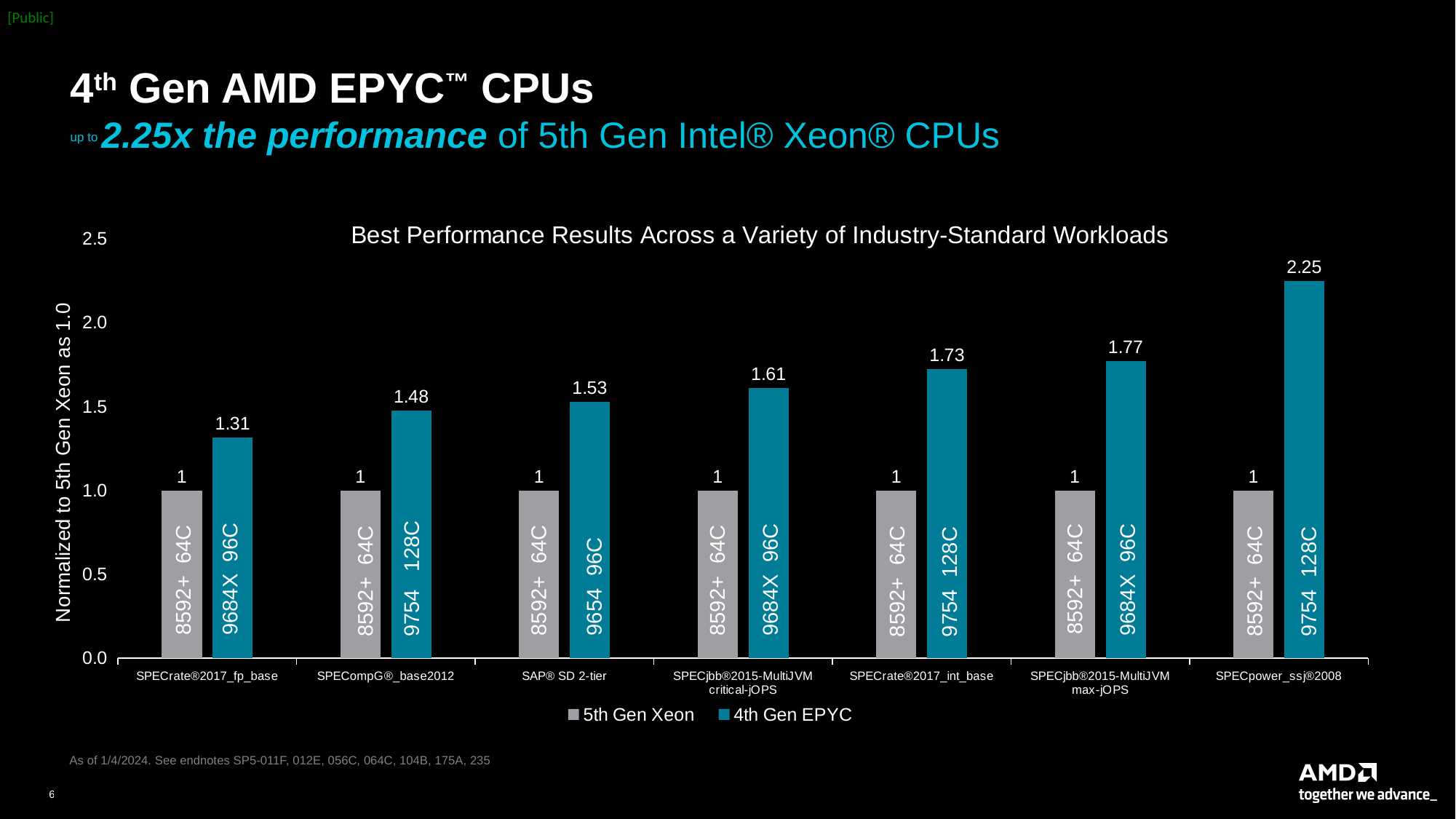
What is the title of the chart? Best Performance Results Across a Variety of Industry-Standard Workloads What kind of chart is shown on the slide? bar chart How many series does the legend list? 2 What is the 4th Gen EPYC value for SAP® SD 2-tier? 1.53 Which workload has the highest 4th Gen EPYC value? SPECpower_ssj®2008 What is the 4th Gen EPYC value for SPECrate®2017_fp_base? 1.31 How many workload categories are shown on the x axis? 7 What is the difference between the 4th Gen EPYC values for SPECjbb®2015-MultiJVM max-jOPS and SPECjbb®2015-MultiJVM critical-jOPS? 0.16 Is the 4th Gen EPYC value for SPECpower_ssj®2008 greater or less than 2.0? greater What is the 4th Gen EPYC value for SPECpower_ssj®2008? 2.25 Which is larger: the 4th Gen EPYC value for SPECompG®_base2012 or for SPECrate®2017_int_base? SPECrate®2017_int_base Which workload has the lowest 4th Gen EPYC value? SPECrate®2017_fp_base